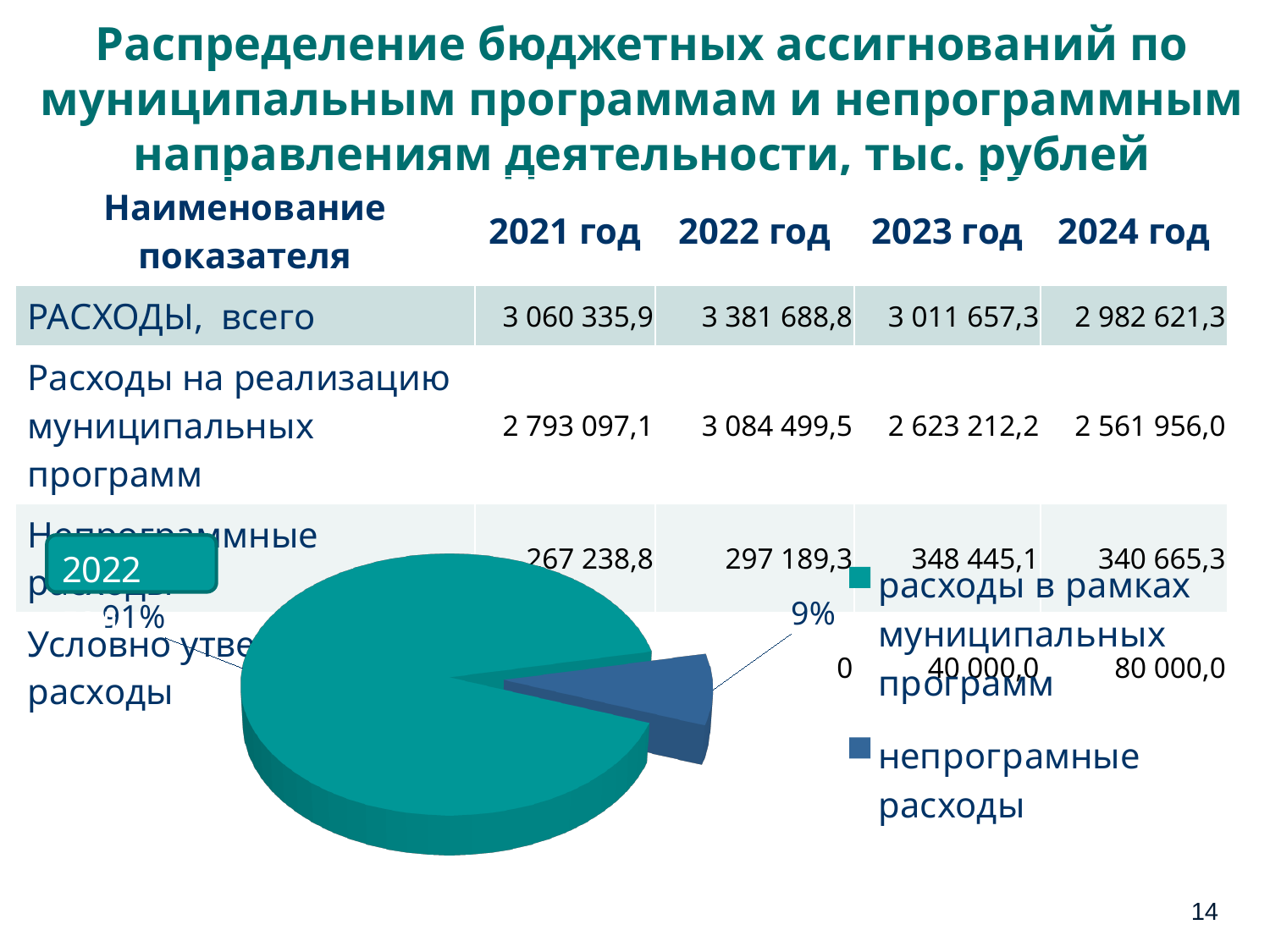
What share of the pie chart is labelled for расходы в рамках муниципальных программ? 91% What colour is the slice for непрограмные расходы in the pie chart? blue What kind of chart is shown on the slide? pie chart What share of the pie chart is labelled for непрограмные расходы? 9% How many entries does the pie chart's legend list? 2 Which slice of the pie chart is the smallest? непрограмные расходы In the pie chart, which is larger: расходы в рамках муниципальных программ or непрограмные расходы? расходы в рамках муниципальных программ How many slices does the pie chart have? 2 What is the difference in percentage points between the two slices of the pie chart? 82 Which slice of the pie chart is the largest? расходы в рамках муниципальных программ Which year does the pie chart's label box indicate the data is for? 2022